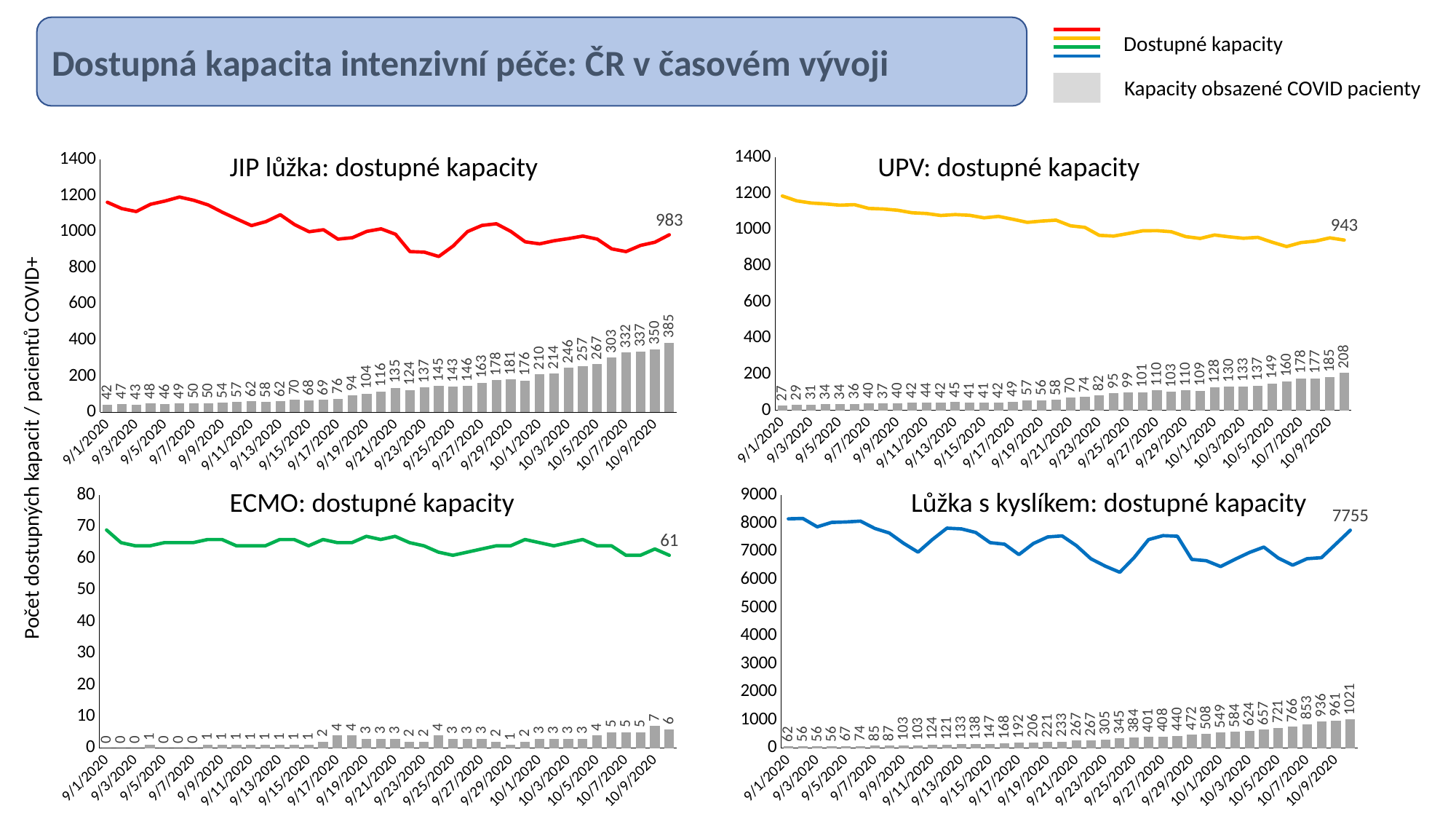
According to the legend, what do the gray bars represent? Kapacity obsazené COVID pacienty Which final line value is larger: 983 in the 'JIP lůžka' chart or 943 in the 'UPV' chart? JIP lůžka (983) In the 'JIP lůžka: dostupné kapacity' chart, what is the difference between the rightmost gray bar (385) and the gray bar for 9/1/2020 (42)? 343 In the 'UPV: dostupné kapacity' chart, what is the value of the gray bar for 9/1/2020? 27 In the 'ECMO: dostupné kapacity' chart, what is the final labeled value of the green line? 61 In the 'UPV: dostupné kapacity' chart, does the yellow line generally rise or fall from 9/1/2020 to the end? fall In the 'Lůžka s kyslíkem: dostupné kapacity' chart, what is the final labeled value of the blue line? 7755 In the 'UPV: dostupné kapacity' chart, what is the final labeled value of the yellow line? 943 In the 'JIP lůžka: dostupné kapacity' chart, what is the final labeled value of the red line? 983 In the 'JIP lůžka: dostupné kapacity' chart, what is the value of the rightmost gray bar? 385 In the 'Lůžka s kyslíkem: dostupné kapacity' chart, what is the value of the rightmost gray bar? 1021 In the 'JIP lůžka: dostupné kapacity' chart, is the red line value at 9/1/2020 greater or less than 1000? greater